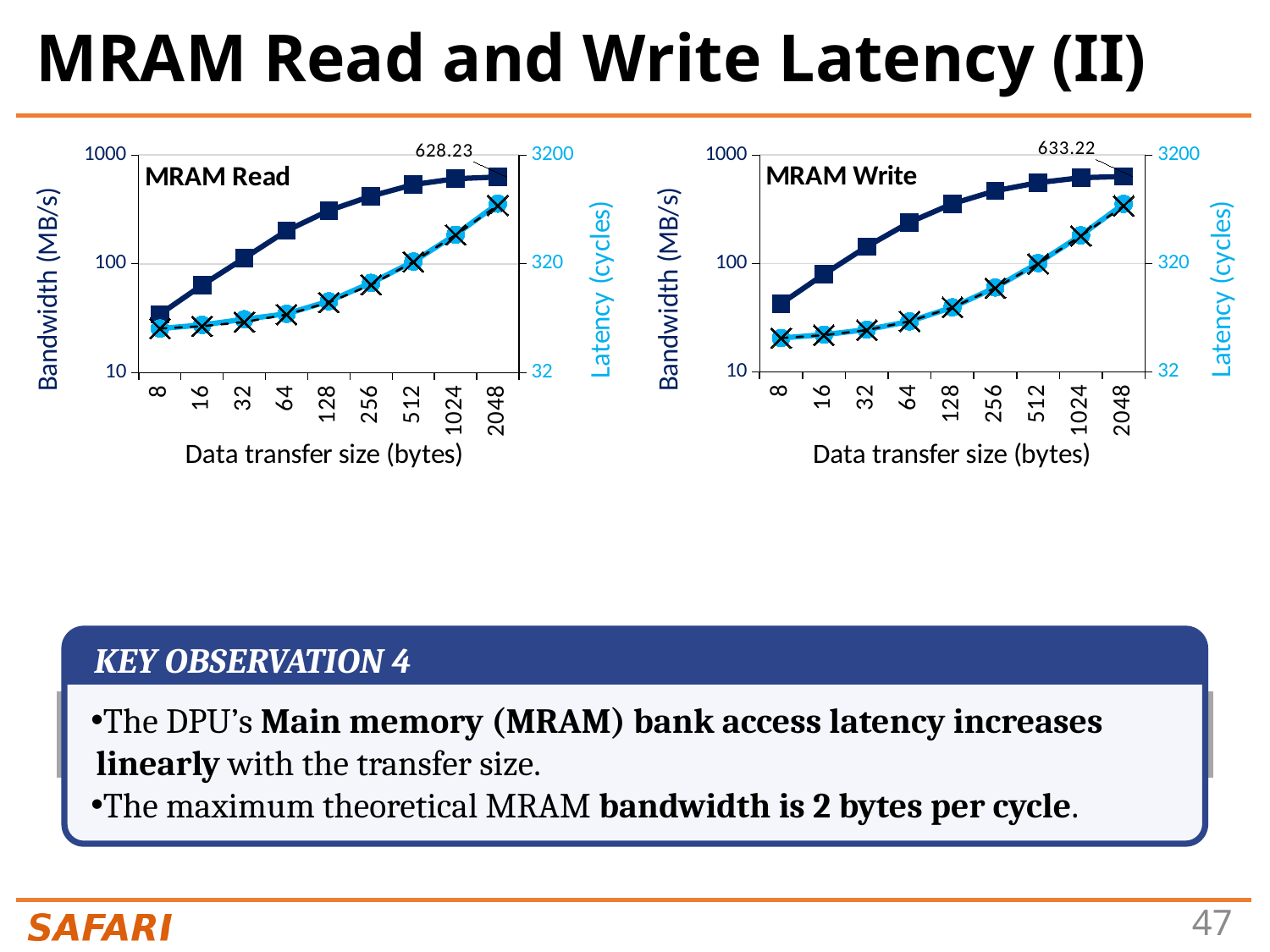
In the MRAM Write chart, is the latency at 8 bytes greater or less than 320 cycles? less In the MRAM Read chart, how many data transfer sizes are plotted along the x axis? 9 In the MRAM Read chart, what is the bandwidth at a data transfer size of 2048 bytes? 628.23 Comparing the labelled bandwidth values at 2048 bytes, which chart shows the larger value, MRAM Read or MRAM Write? MRAM Write In the MRAM Write chart, which data transfer size has the lowest bandwidth? 8 What is the x-axis title of the MRAM Read chart? Data transfer size (bytes) What kind of chart is the MRAM Write chart? Line chart In the MRAM Read chart, is the bandwidth at 512 bytes greater or less than 100 MB/s? greater In the MRAM Read chart, does bandwidth rise or fall as the data transfer size increases? Rises In the MRAM Write chart, what is the bandwidth at a data transfer size of 2048 bytes? 633.22 In the MRAM Write chart, is the latency at 2048 bytes greater or less than 320 cycles? greater